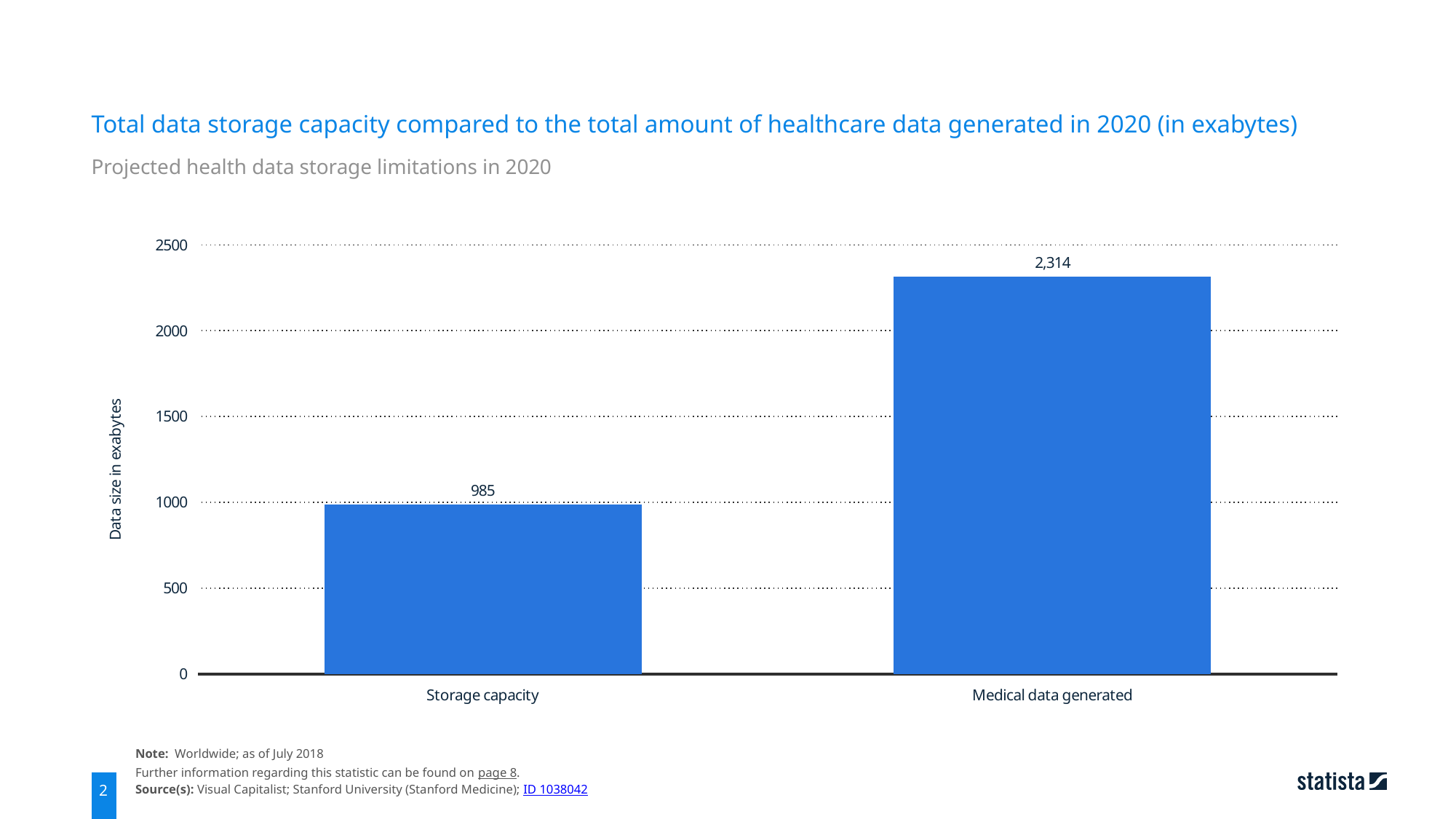
Which is larger, Storage capacity or Medical data generated? Medical data generated What is the value for Storage capacity? 985 Is the value for Storage capacity greater or less than 1000? less What is the difference between Medical data generated and Storage capacity? 1,329 Which category has the highest value? Medical data generated What is the value for Medical data generated? 2,314 How many categories are shown on the chart? 2 Which category has the lowest value? Storage capacity What kind of chart is shown on the slide? Bar chart Is the value for Medical data generated greater or less than 2000? greater What is the subtitle of the chart? Projected health data storage limitations in 2020 What is the label of the y axis? Data size in exabytes